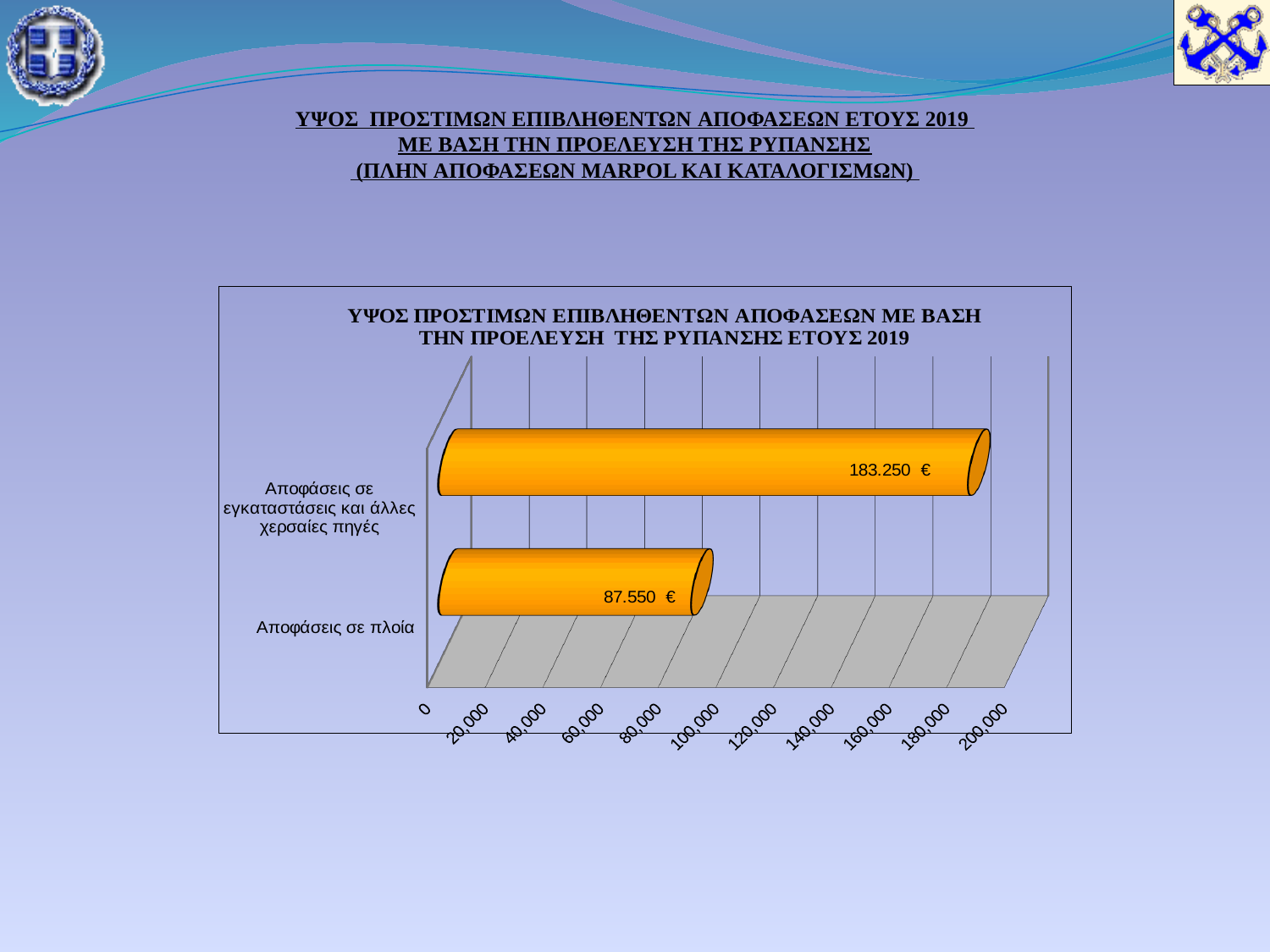
Which is larger: the value for Αποφάσεις σε πλοία or the value for Αποφάσεις σε εγκαταστάσεις και άλλες χερσαίες πηγές? Αποφάσεις σε εγκαταστάσεις και άλλες χερσαίες πηγές What kind of chart is shown on the slide? Bar chart Which category has the highest value? Αποφάσεις σε εγκαταστάσεις και άλλες χερσαίες πηγές Is the value for Αποφάσεις σε εγκαταστάσεις και άλλες χερσαίες πηγές greater or less than 160.000? greater What is the difference between the value for Αποφάσεις σε εγκαταστάσεις και άλλες χερσαίες πηγές and the value for Αποφάσεις σε πλοία? 95.700 € What is the highest value shown on the chart's value axis? 200,000 What is the value for Αποφάσεις σε εγκαταστάσεις και άλλες χερσαίες πηγές? 183.250 € Is the value for Αποφάσεις σε πλοία greater or less than 100.000? less What is the value for Αποφάσεις σε πλοία? 87.550 € Which category has the lowest value? Αποφάσεις σε πλοία What is the title of the chart? ΥΨΟΣ ΠΡΟΣΤΙΜΩΝ ΕΠΙΒΛΗΘΕΝΤΩΝ ΑΠΟΦΑΣΕΩΝ ΜΕ ΒΑΣΗ ΤΗΝ ΠΡΟΕΛΕΥΣΗ ΤΗΣ ΡΥΠΑΝΣΗΣ ΕΤΟΥΣ 2019 How many categories are shown in the chart? 2